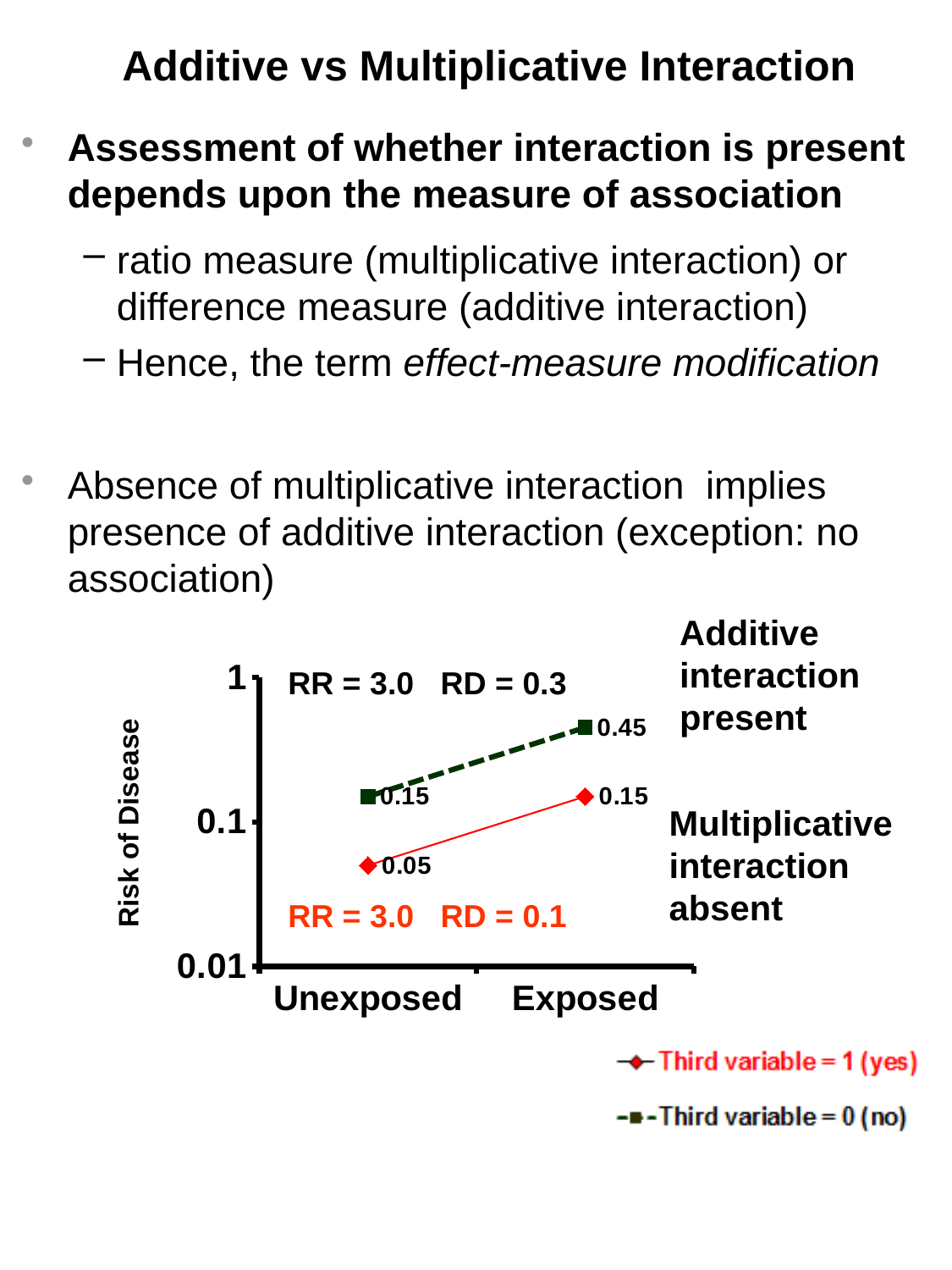
What is the risk of disease for the Unexposed group in the Third variable = 1 (yes) series? 0.05 Does the risk of disease rise or fall from Unexposed to Exposed in the Third variable = 1 (yes) series? rise How many series does the legend list? 2 What is the risk of disease for the Unexposed group in the Third variable = 0 (no) series? 0.15 What is the risk of disease for the Exposed group in the Third variable = 0 (no) series? 0.45 How many categories are shown on the x axis? 2 What kind of chart is shown on the slide? line chart Is the risk of disease for the Exposed group in the Third variable = 0 (no) series greater or less than 0.1? greater What is the difference in risk of disease between Exposed and Unexposed in the Third variable = 0 (no) series? 0.3 What is the difference in risk of disease between Exposed and Unexposed in the Third variable = 1 (yes) series? 0.1 Which series has the higher risk of disease for the Exposed group? Third variable = 0 (no) What is the risk of disease for the Exposed group in the Third variable = 1 (yes) series? 0.15